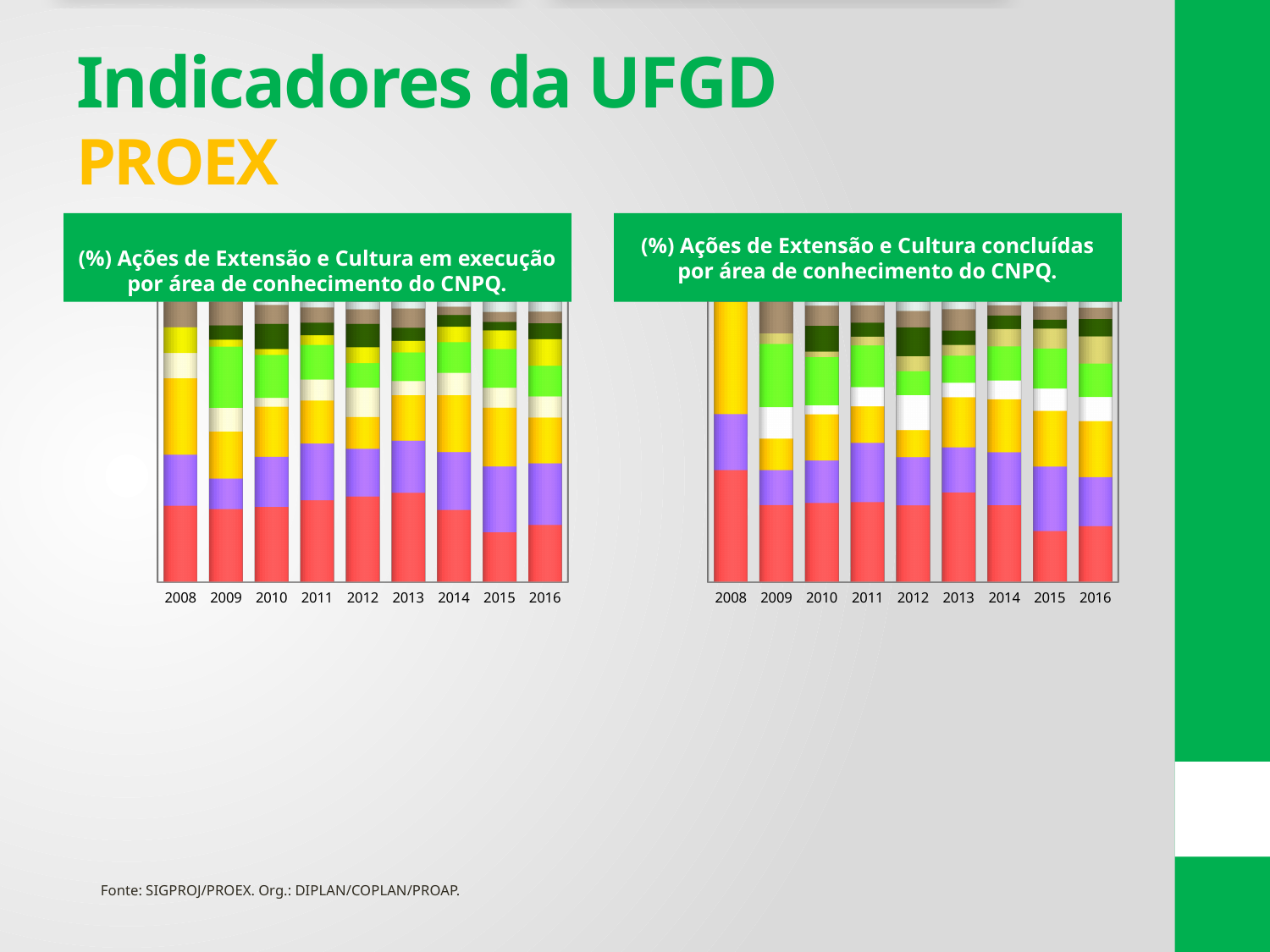
What is the first year shown on the x axis of the left chart, '(%) Ações de Extensão e Cultura em execução por área de conhecimento do CNPQ.'? 2008 What kind of chart is the right chart, '(%) Ações de Extensão e Cultura concluídas por área de conhecimento do CNPQ.'? Stacked bar chart How many years are shown on the x axis of the right chart, '(%) Ações de Extensão e Cultura concluídas por área de conhecimento do CNPQ.'? 9 In the right chart, '(%) Ações de Extensão e Cultura concluídas por área de conhecimento do CNPQ.', which year has the largest yellow segment? 2008 In the right chart, '(%) Ações de Extensão e Cultura concluídas por área de conhecimento do CNPQ.', is the red segment larger in 2013 or in 2015? 2013 In the left chart, '(%) Ações de Extensão e Cultura em execução por área de conhecimento do CNPQ.', is the red segment larger in 2013 or in 2015? 2013 What kind of chart is the left chart, '(%) Ações de Extensão e Cultura em execução por área de conhecimento do CNPQ.'? Stacked bar chart In the right chart, '(%) Ações de Extensão e Cultura concluídas por área de conhecimento do CNPQ.', is the yellow segment larger in 2008 or in 2009? 2008 What is the last year shown on the x axis of the right chart, '(%) Ações de Extensão e Cultura concluídas por área de conhecimento do CNPQ.'? 2016 How many years are shown on the x axis of the left chart, '(%) Ações de Extensão e Cultura em execução por área de conhecimento do CNPQ.'? 9